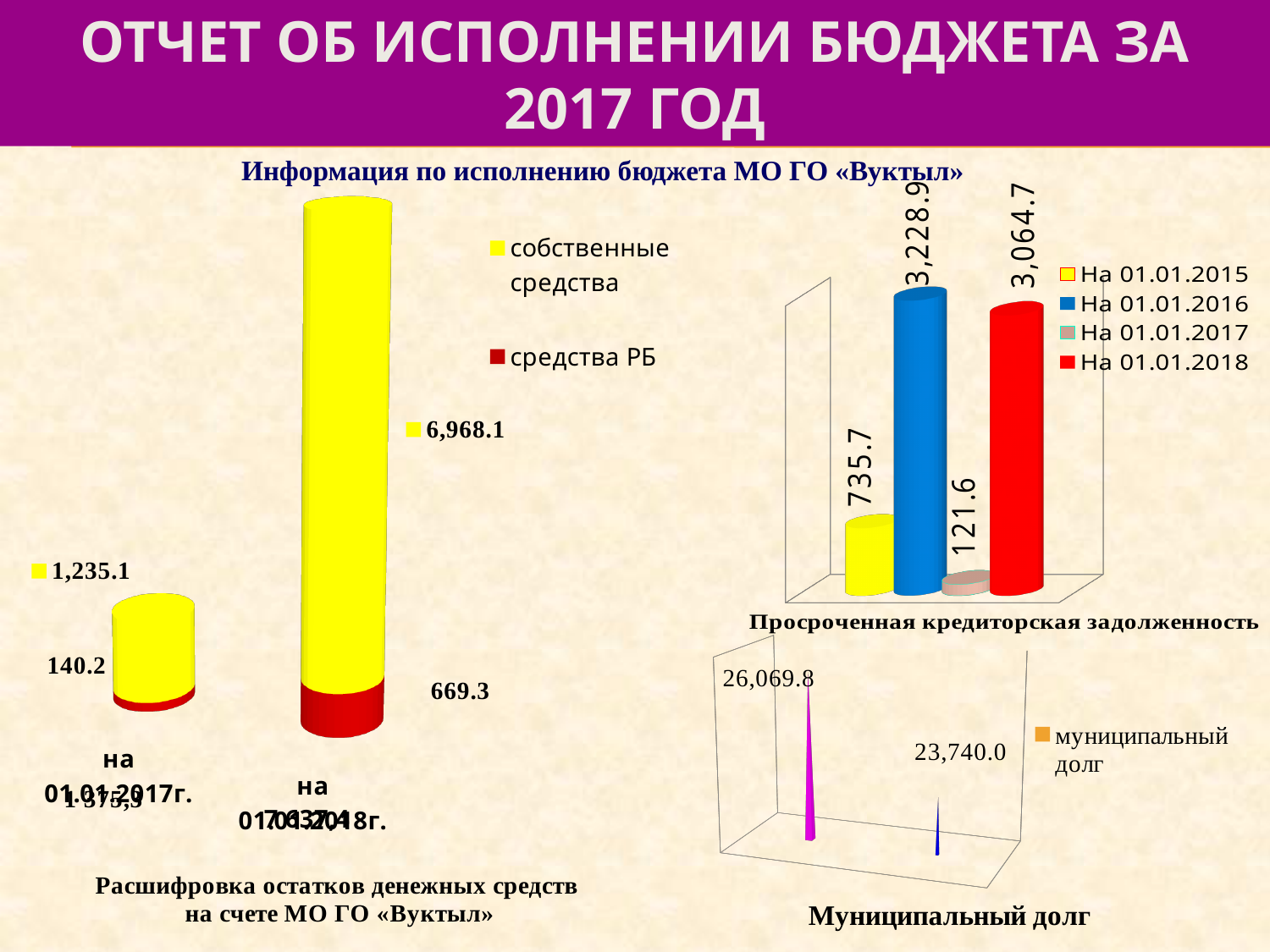
In the chart 'Расшифровка остатков денежных средств на счете МО ГО «Вуктыл»', how many series does the legend list? 2 In the chart 'Просроченная кредиторская задолженность', which date has the highest value? На 01.01.2016 In the chart 'Просроченная кредиторская задолженность', which date has the lowest value? На 01.01.2017 In the chart 'Просроченная кредиторская задолженность', what is the value for На 01.01.2016? 3,228.9 In the chart 'Муниципальный долг', what is the difference between the two plotted values? 2,329.8 In the chart 'Расшифровка остатков денежных средств на счете МО ГО «Вуктыл»', what is the total of the stacked bar for 01.01.2017? 1,375.3 In the chart 'Просроченная кредиторская задолженность', what is the difference between the values for На 01.01.2016 and На 01.01.2018? 164.2 In the chart 'Расшифровка остатков денежных средств на счете МО ГО «Вуктыл»', what is the difference between собственные средства on 01.01.2018 and on 01.01.2017? 5,733.0 In the chart 'Муниципальный долг', which of the two plotted values is larger? 26,069.8 In the chart 'Расшифровка остатков денежных средств на счете МО ГО «Вуктыл»', what is the value of собственные средства on 01.01.2018? 6,968.1 In the chart 'Расшифровка остатков денежных средств на счете МО ГО «Вуктыл»', what is the value of средства РБ on 01.01.2017? 140.2 In the chart 'Расшифровка остатков денежных средств на счете МО ГО «Вуктыл»', what is the value of средства РБ on 01.01.2018? 669.3